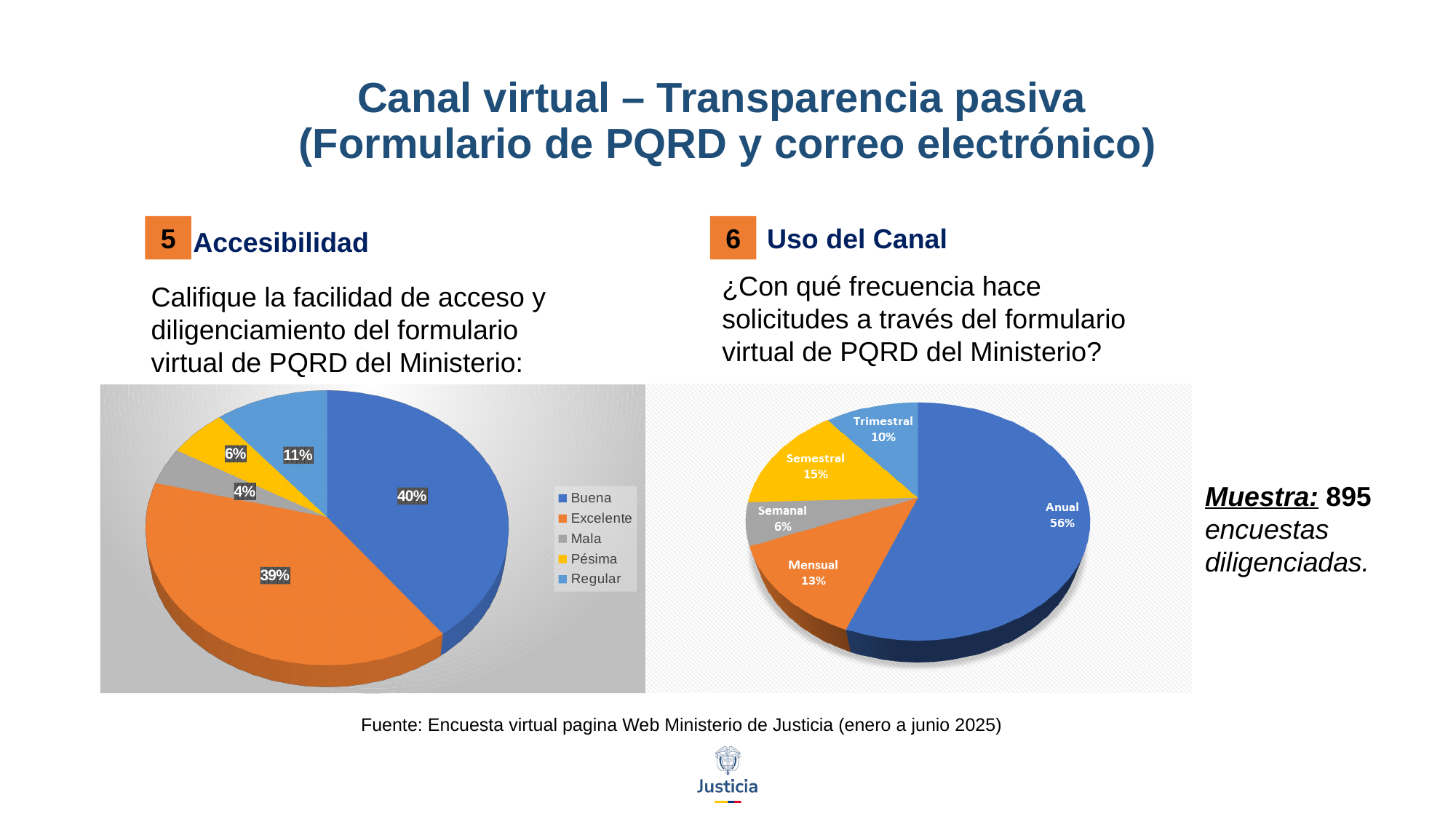
In the Accesibilidad pie chart on the left, which category has the smallest share? Mala In the Uso del Canal pie chart on the right, what percentage is labelled for Semestral? 15% In the Uso del Canal pie chart on the right, what is the difference in percentage points between Anual and Semanal? 50 In the Accesibilidad pie chart on the left, what percentage is labelled for Buena? 40% In the Uso del Canal pie chart on the right, which category has the largest share? Anual In the Accesibilidad pie chart on the left, what percentage is labelled for Regular? 11% In the Accesibilidad pie chart on the left, what is the difference in percentage points between Buena and Excelente? 1 In the Uso del Canal pie chart on the right, which is larger, Mensual or Trimestral? Mensual In the Accesibilidad pie chart on the left, which colour represents Pésima? Yellow What type of chart is used for the Uso del Canal data on the right? Pie chart In the Uso del Canal pie chart on the right, what percentage is labelled for Anual? 56% In the Accesibilidad pie chart on the left, how many categories does the legend list? 5